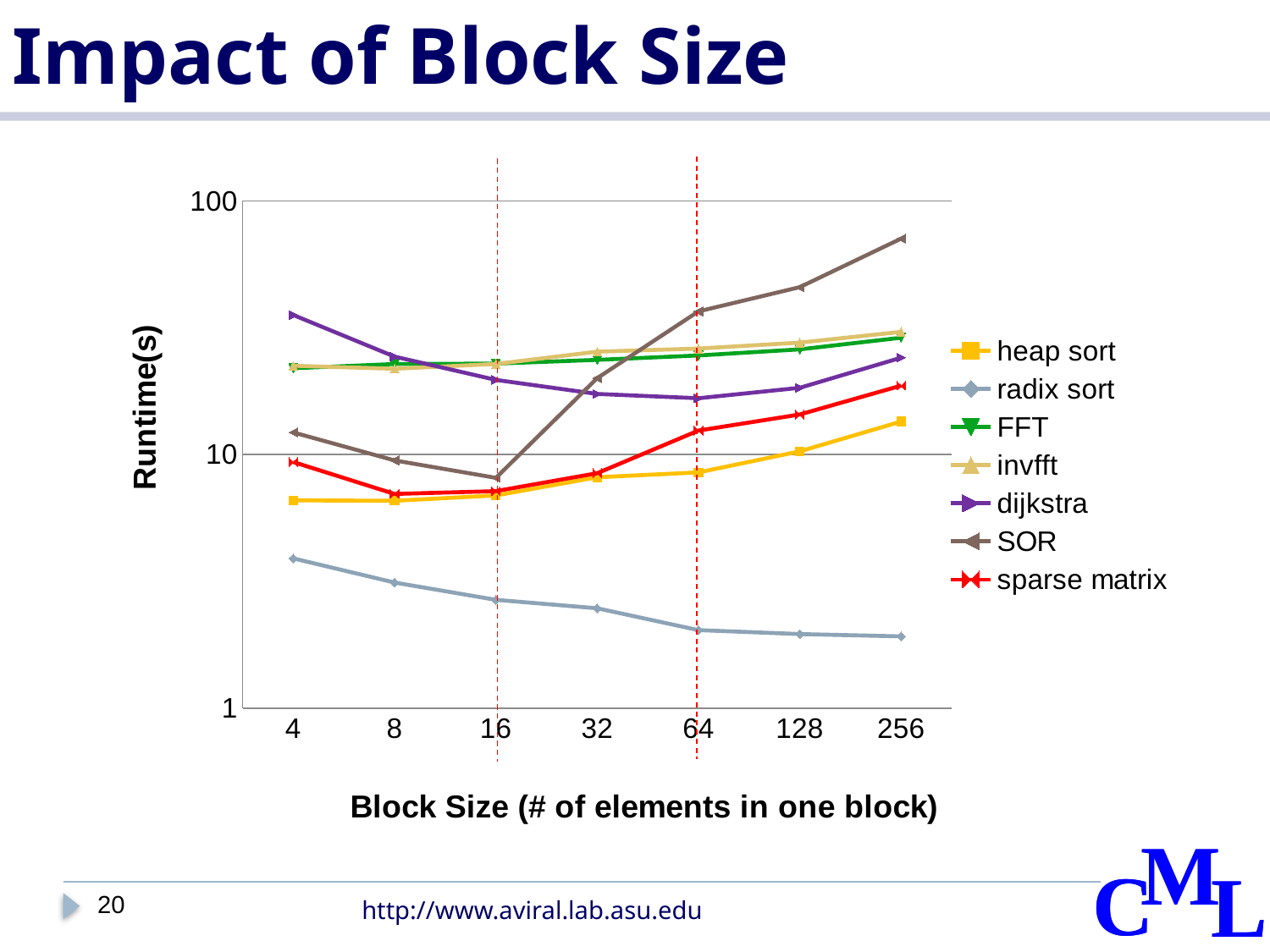
Is the runtime for SOR at block size 16 greater or less than 10? less Which series has the lowest runtime at block size 4? radix sort Does the runtime for radix sort rise or fall as block size increases? fall How many series does the legend list? 7 Is the runtime for SOR at block size 256 greater or less than 10? greater At block size 256, which has the larger runtime: heap sort or sparse matrix? sparse matrix Is the runtime for dijkstra at block size 4 greater or less than 10? greater How many block size values are plotted along the x axis? 7 What kind of chart is shown on the slide? line chart Which series has the highest runtime at block size 256? SOR What is the title of the x axis? Block Size (# of elements in one block)